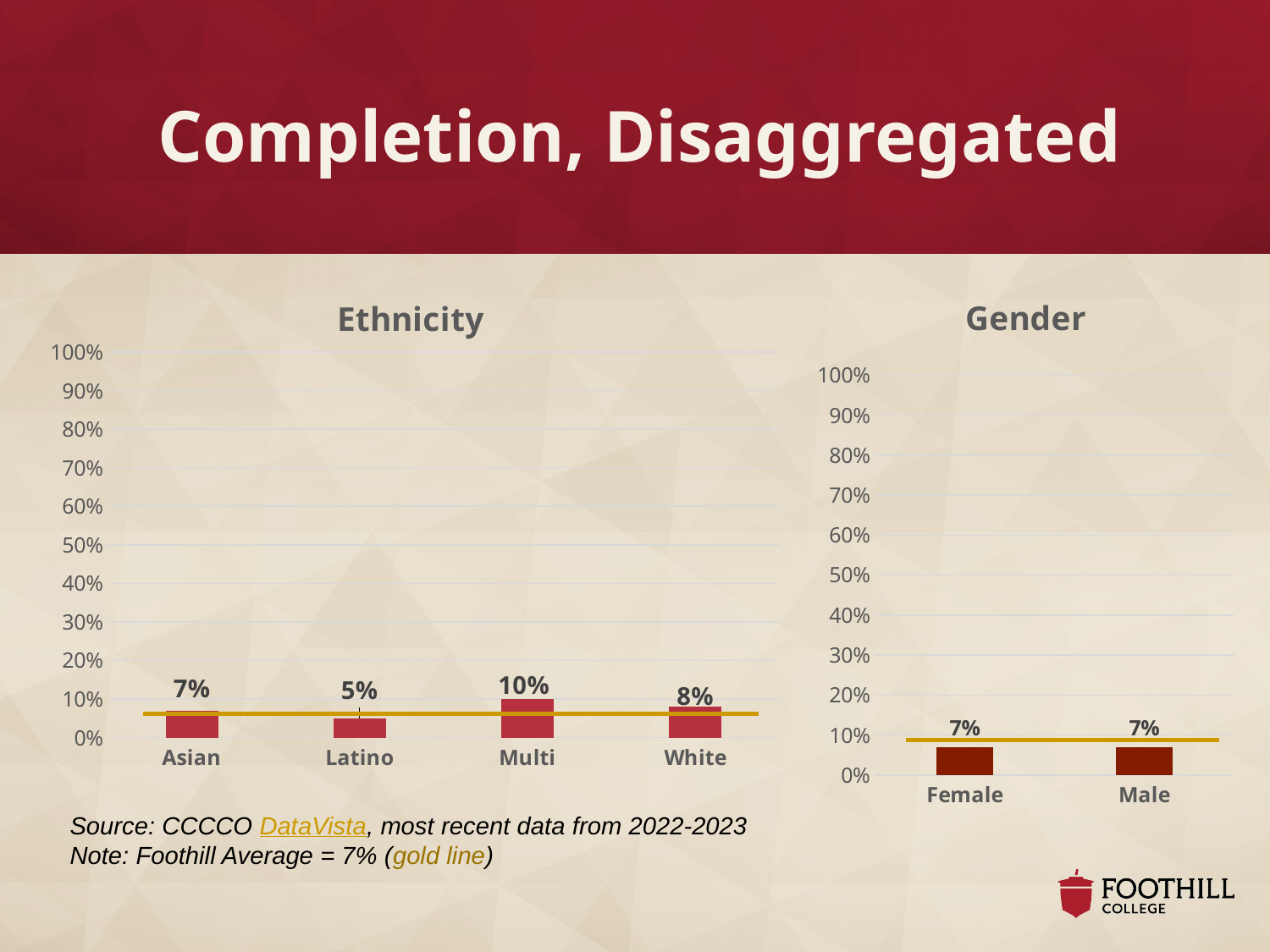
In the Ethnicity chart, what is the completion value for Latino? 5% What kind of chart is the Gender chart? Bar chart In the Ethnicity chart, which category has the highest completion value? Multi In the Ethnicity chart, which is larger, the value for White or the value for Asian? White According to the note on the slide, what does the gold line across the charts represent? Foothill Average = 7% In the Ethnicity chart, what is the difference between the values for Multi and Latino? 5% In the Gender chart, what is the completion value for Female? 7% In the Ethnicity chart, which category has the lowest completion value? Latino In the Ethnicity chart, how many ethnicity categories are shown? 4 In the Ethnicity chart, what is the completion value for Multi? 10% In the Gender chart, how many categories are shown? 2 In the Gender chart, what is the difference between the values for Female and Male? 0%